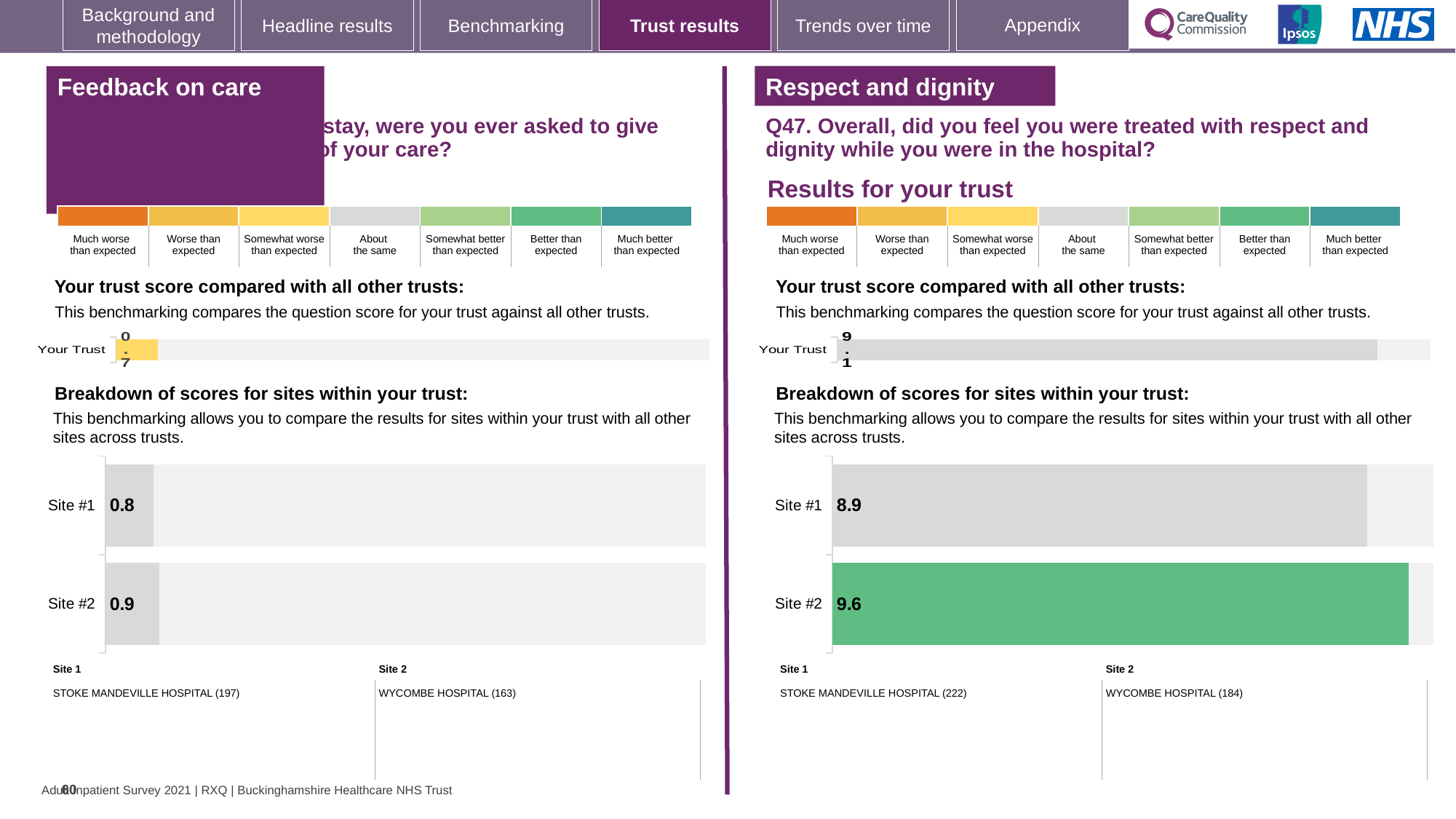
In the 'Feedback on care' site breakdown chart on the left, what is the score for Site #1? 0.8 In the 'Respect and dignity' site breakdown chart on the right, which site has the higher score? Site #2 In the 'Respect and dignity' site breakdown chart on the right, what colour is the bar for Site #2? Green In the 'Feedback on care' site breakdown chart on the left, what is the score for Site #2? 0.9 In the 'Feedback on care' site breakdown chart on the left, what is the difference between the Site #2 and Site #1 scores? 0.1 In the 'Respect and dignity' 'Your Trust' chart on the right, what is the trust score? 9.1 In the 'Respect and dignity' site breakdown chart on the right, what is the difference between the Site #2 and Site #1 scores? 0.7 What type of chart is used for the site breakdown in the 'Feedback on care' section on the left? Bar chart In the 'Feedback on care' site breakdown chart on the left, which site has the lower score? Site #1 How many sites are shown in the 'Respect and dignity' site breakdown chart on the right? 2 In the 'Respect and dignity' site breakdown chart on the right, what is the score for Site #2? 9.6 In the 'Respect and dignity' site breakdown chart on the right, what is the score for Site #1? 8.9